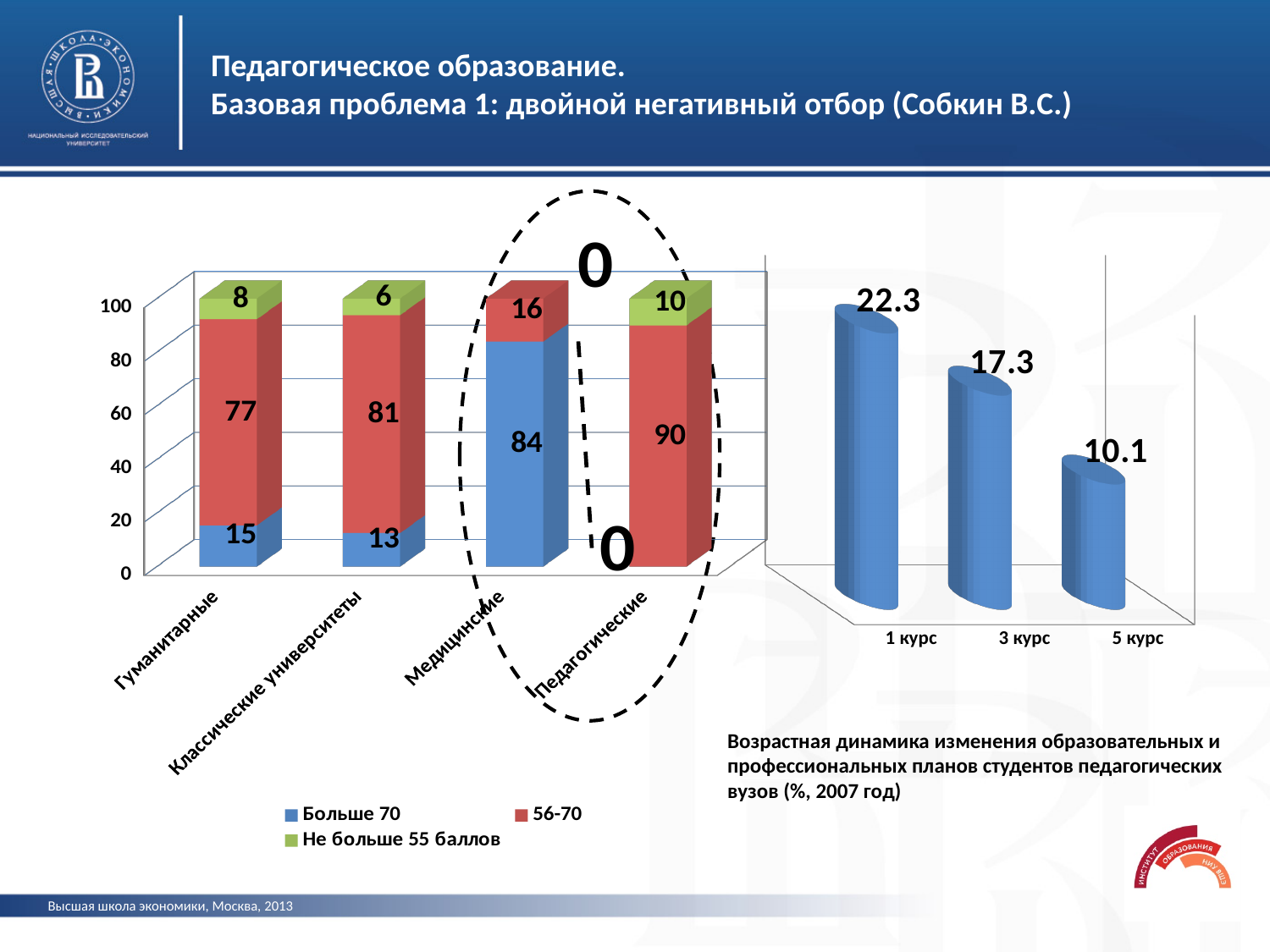
In the left stacked bar chart, what is the value of the '56-70' series for Педагогические? 90 In the left stacked bar chart, which category has the highest value for the 'Больше 70' series? Медицинские In the left stacked bar chart, what is the value of the 'Не больше 55 баллов' series for Гуманитарные? 8 In the left stacked bar chart, what is the difference between the '56-70' values for Классические университеты and Гуманитарные? 4 In the right chart, do the values rise or fall from 1 курс to 5 курс? fall In the right chart, which course has the lowest value? 5 курс In the left stacked bar chart, how many categories are shown on the x axis? 4 In the left stacked bar chart, how many series does the legend list? 3 In the right chart, what is the value for 3 курс? 17.3 In the left stacked bar chart, what is the value of the 'Больше 70' series for Медицинские? 84 What kind of chart is the right chart? bar chart In the left stacked bar chart, what is the total of the stacked bar for Классические университеты? 100